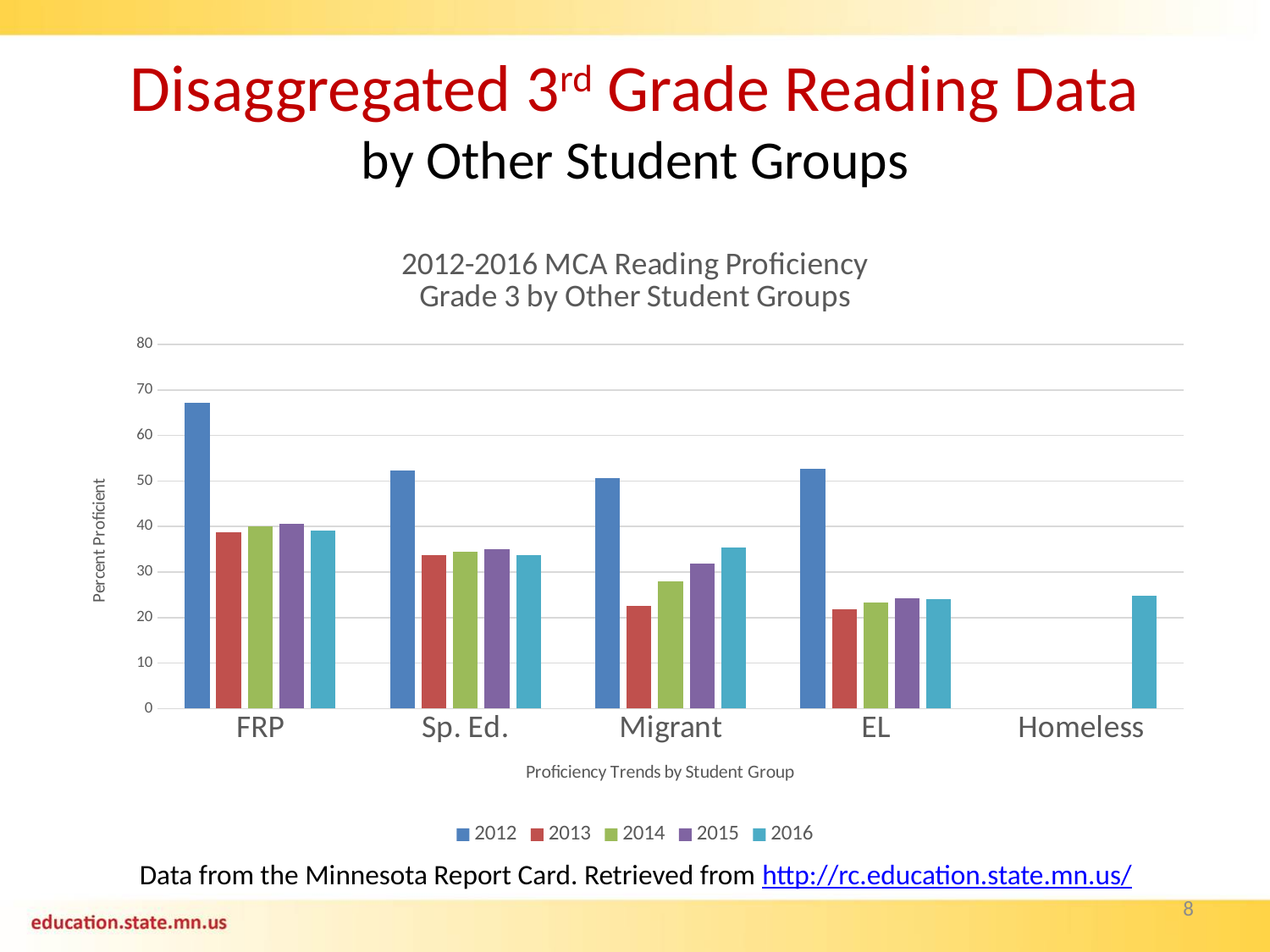
Is the 2012 value for FRP greater or less than 60? greater Is the 2013 value for Migrant greater or less than 30? less Which student group has a bar for only one year? Homeless Which is larger, the 2016 value for Migrant or the 2016 value for EL? Migrant Which year has the highest bar for Sp. Ed.? 2012 Is the 2016 value for Homeless greater or less than 20? greater Which student group has the highest 2012 bar? FRP How many student groups are shown on the x axis? 5 For the Migrant group, do the values rise or fall from 2013 to 2016? rise What is the label on the vertical axis of the chart? Percent Proficient What kind of chart is shown on the slide? bar chart How many series does the legend list? 5